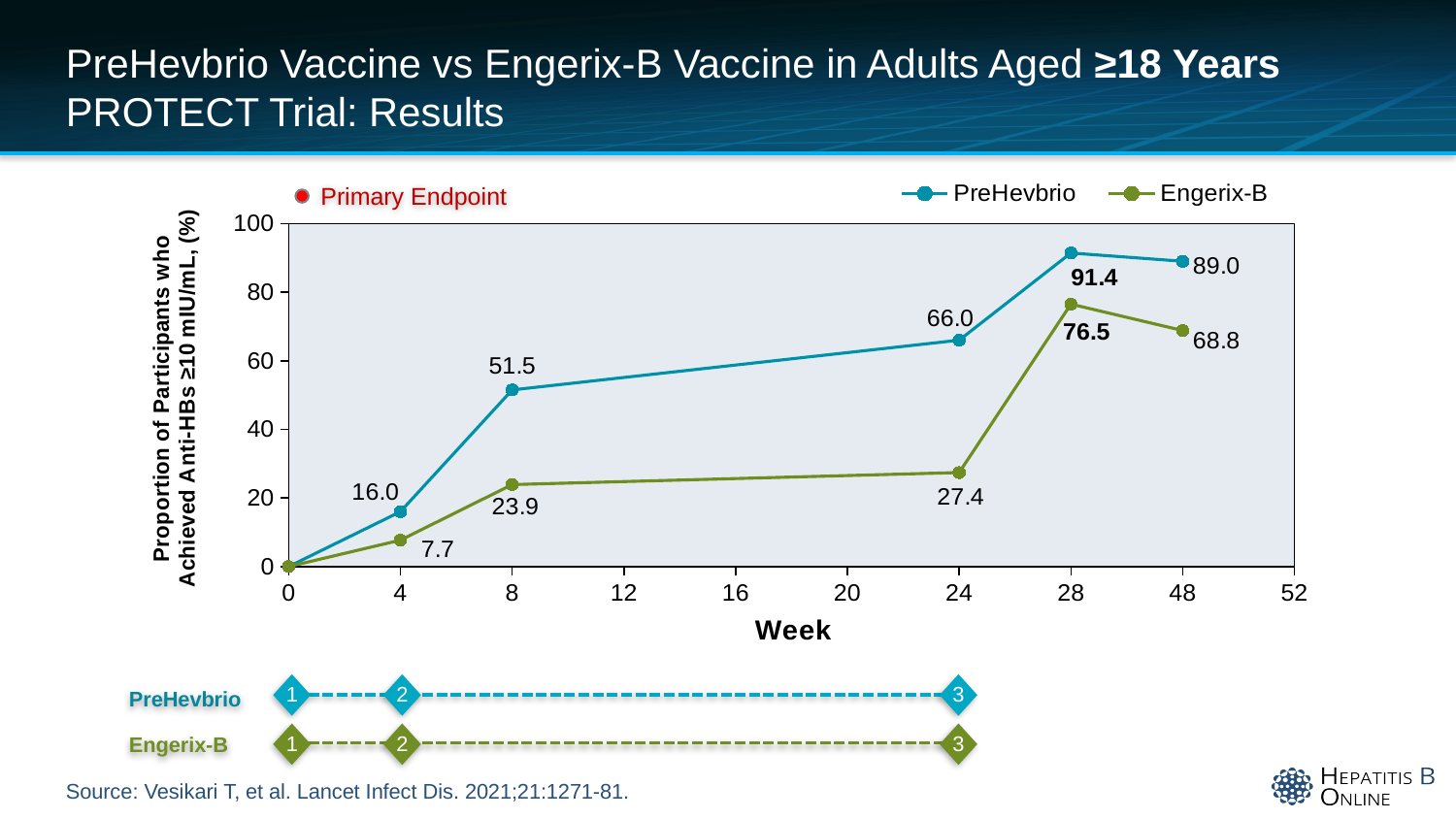
What is the label of the x axis? Week What is the difference between PreHevbrio and Engerix-B at week 28? 14.9 Is the value for Engerix-B at week 24 greater or less than 40? less How many series does the legend list? 2 What is the difference between PreHevbrio and Engerix-B at week 24? 38.6 What kind of chart is shown? line chart What is the value for Engerix-B at week 48? 68.8 What is the value for PreHevbrio at week 28? 91.4 Which series has the larger value at week 8, PreHevbrio or Engerix-B? PreHevbrio What is the value for Engerix-B at week 8? 23.9 At which week does the PreHevbrio series reach its highest value? 28 What is the value for PreHevbrio at week 4? 16.0